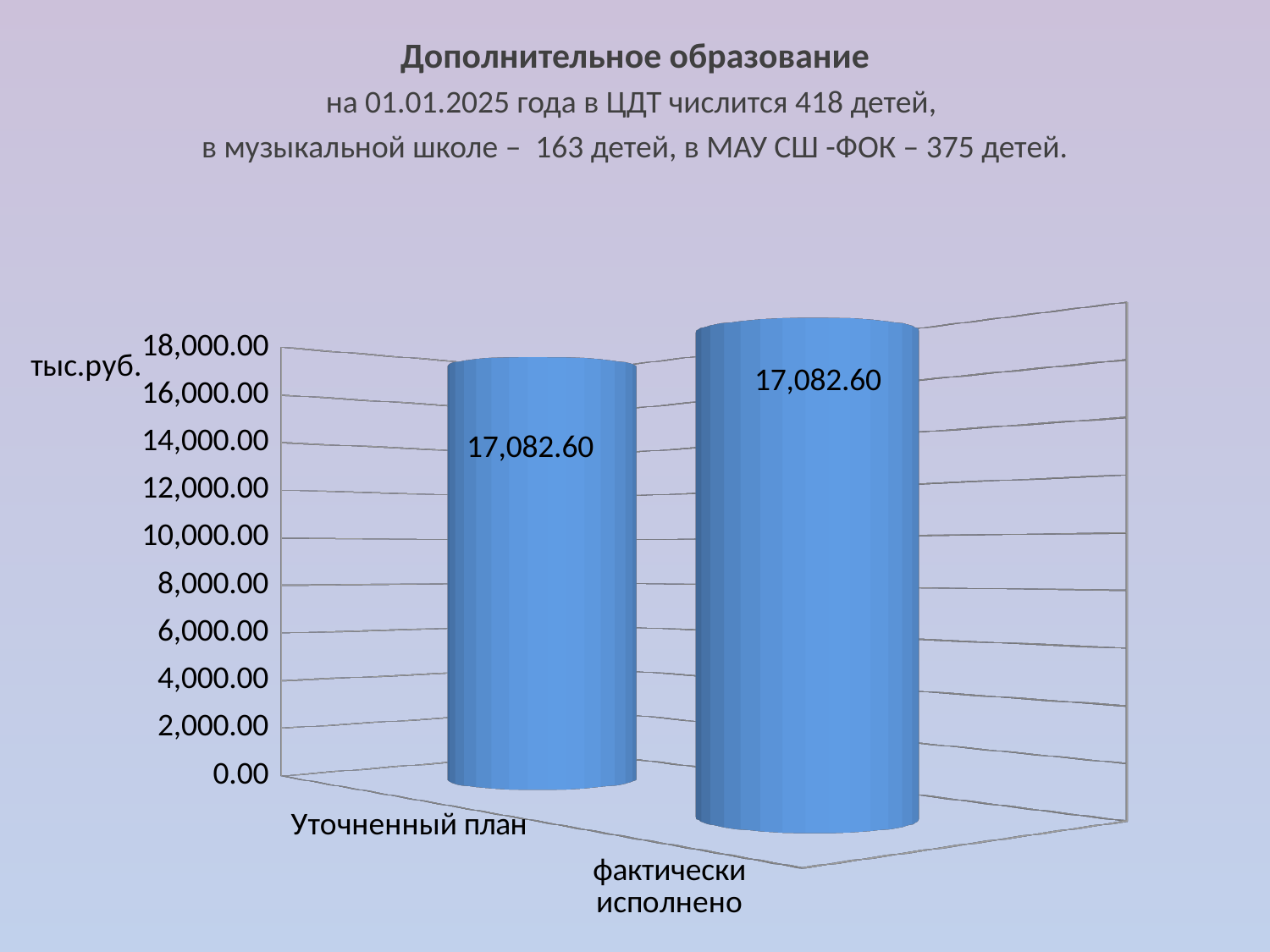
How many categories are shown on the x axis of the chart? 2 What unit label is shown next to the vertical axis of the chart? тыс.руб. Do the values for Уточненный план and фактически исполнено rise, fall or stay the same along the x axis? stay the same Is the value for фактически исполнено greater or less than 18,000.00? less What is the value for фактически исполнено? 17,082.60 What kind of chart is shown on the slide? bar chart What is the difference between the values for Уточненный план and фактически исполнено? 0.00 What is the highest tick value shown on the vertical axis? 18,000.00 What is the value for Уточненный план? 17,082.60 Is the value for Уточненный план greater or less than 16,000.00? greater